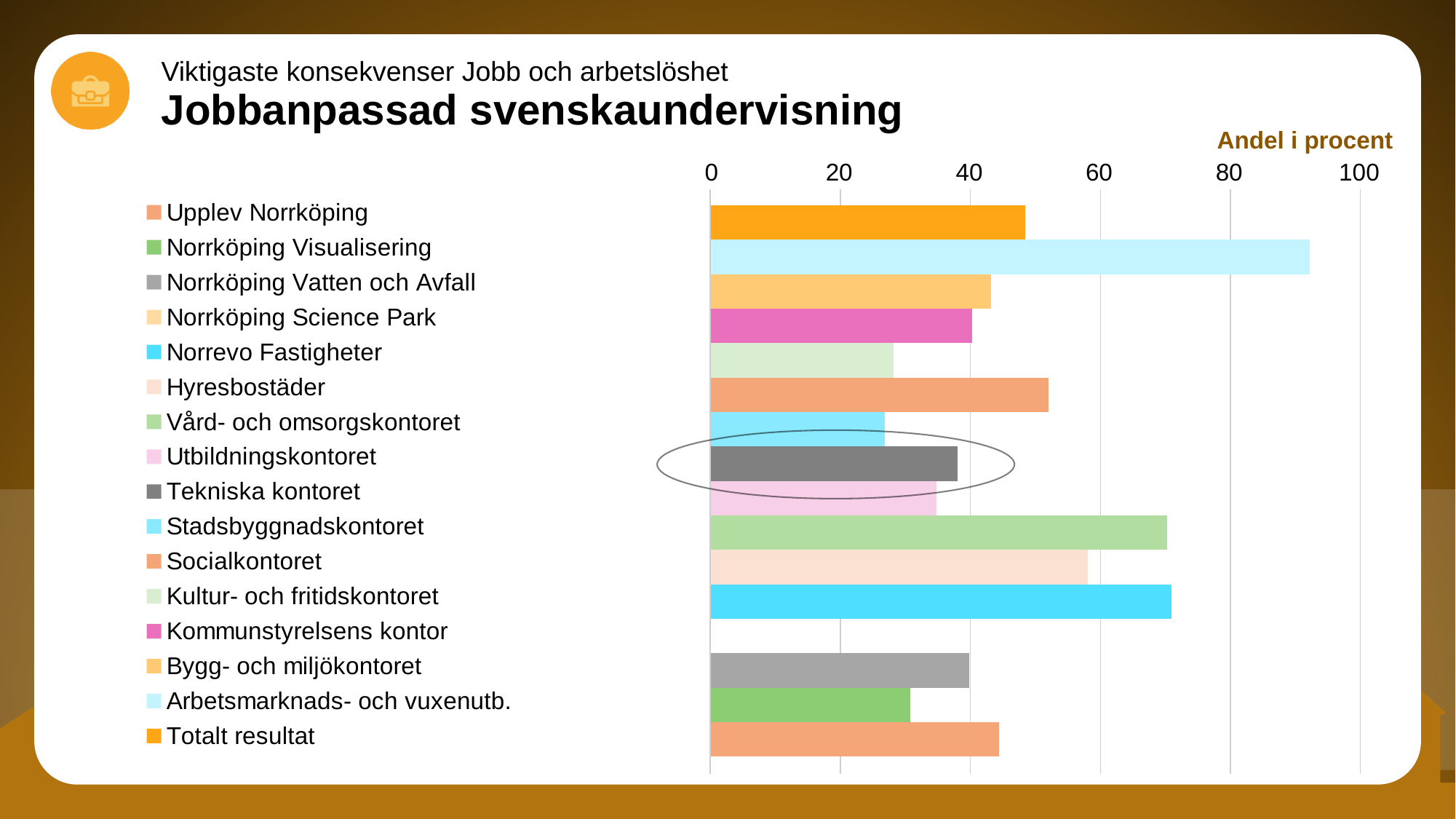
Which is larger, the value for Arbetsmarknads- och vuxenutb. or the value for Totalt resultat? Arbetsmarknads- och vuxenutb. Which is larger, the value for Socialkontoret or the value for Kultur- och fritidskontoret? Socialkontoret Is the value for Totalt resultat greater or less than 40? greater Is the value for Vård- och omsorgskontoret greater or less than 60? greater Which series has the highest value in the chart? Arbetsmarknads- och vuxenutb. Is the value for Stadsbyggnadskontoret greater or less than 40? less What is the highest value shown on the horizontal axis of the chart? 100 How many series does the legend list? 16 What is the label shown above the horizontal axis of the chart? Andel i procent What kind of chart is shown on the slide? bar chart